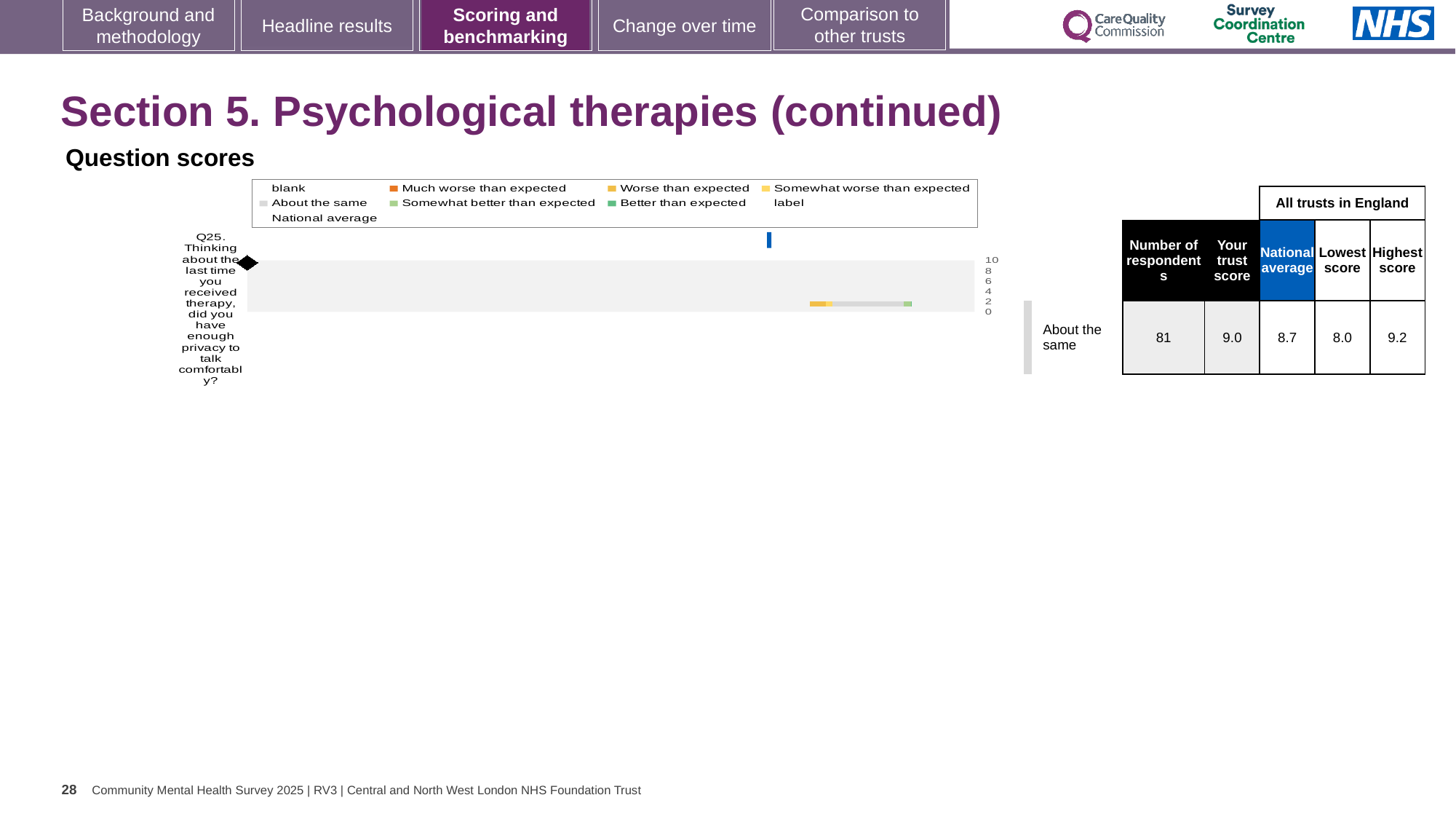
What is the national average score for Q25? 8.7 How many respondents answered Q25? 81 Which benchmarking category is Q25 placed in? About the same What is the highest score among all trusts in England for Q25? 9.2 What is the difference between the trust score and the national average for Q25? 0.3 What is the maximum value shown on the chart's score axis? 10 What is the trust score for Q25 shown next to the chart? 9.0 What is the difference between the highest and lowest scores for Q25? 1.2 What kind of chart is shown under 'Question scores'? bar chart What is the lowest score among all trusts in England for Q25? 8.0 Which is larger for Q25, the trust score or the national average? the trust score How many questions are plotted in the Question scores chart? 1